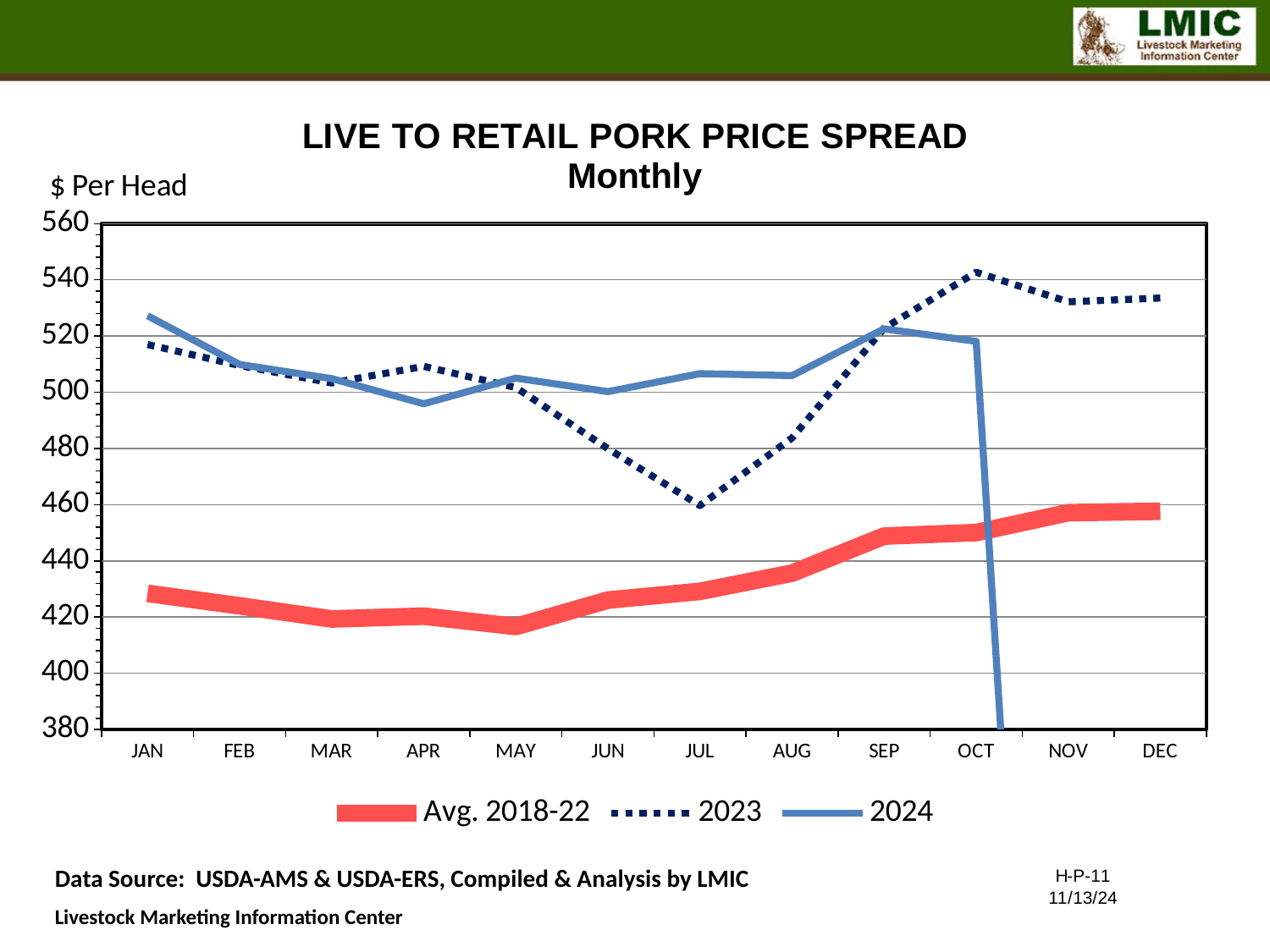
What kind of chart is shown on the slide? Line chart In which month does the 2023 series reach its highest value? OCT Is the 2023 value for JAN greater or less than 500? greater In which month does the 2023 series reach its lowest value? JUL Which is larger in JUL, the 2023 value or the 2024 value? 2024 What is the label on the y axis of the chart? $ Per Head Does the Avg. 2018-22 series rise or fall from MAY to DEC? rise Is the Avg. 2018-22 value for MAY greater or less than 420? less How many months are shown along the x axis? 12 In which month is the Avg. 2018-22 series at its lowest? MAY Is the 2023 value for JUL greater or less than 480? less How many series does the legend list? 3